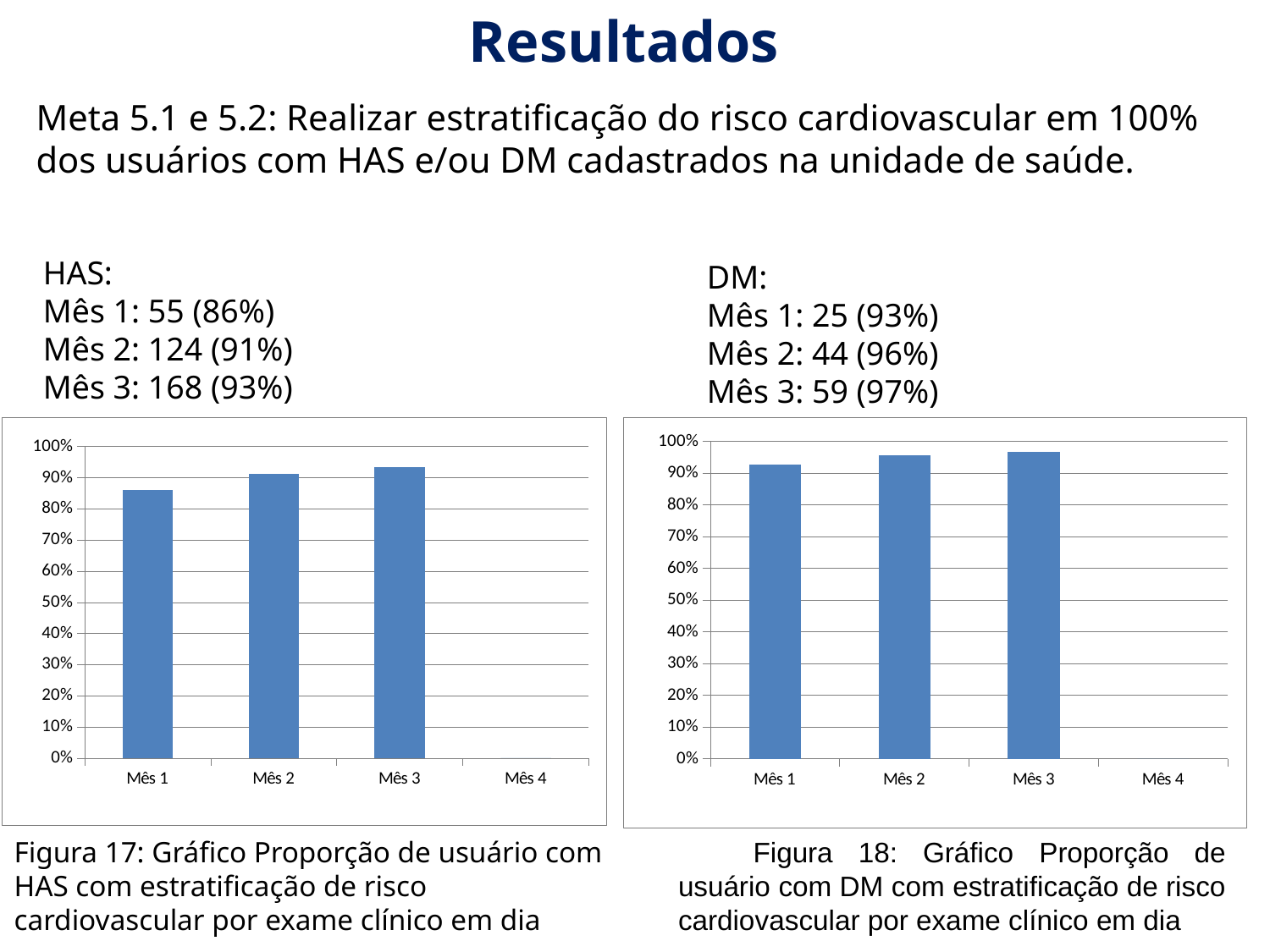
In the left chart (Figura 17, HAS), do the values rise or fall from Mês 1 to Mês 3? rise In the right chart (Figura 18, DM), what is the difference between the values for Mês 3 and Mês 1? 4 percentage points In the left chart (Figura 17, HAS), what is the value for Mês 1? 86% In the left chart (Figura 17, HAS), what is the difference between the values for Mês 3 and Mês 1? 7 percentage points In the right chart (Figura 18, DM), what is the value for Mês 2? 96% In the left chart (Figura 17, HAS), is the value for Mês 1 greater or less than 90%? less In the right chart (Figura 18, DM), what is the value for Mês 3? 97% In the right chart (Figura 18, DM), is the value for Mês 2 greater or less than 90%? greater What kind of chart is the right chart (Figura 18, DM)? bar chart In the left chart (Figura 17, HAS), what is the value for Mês 3? 93%